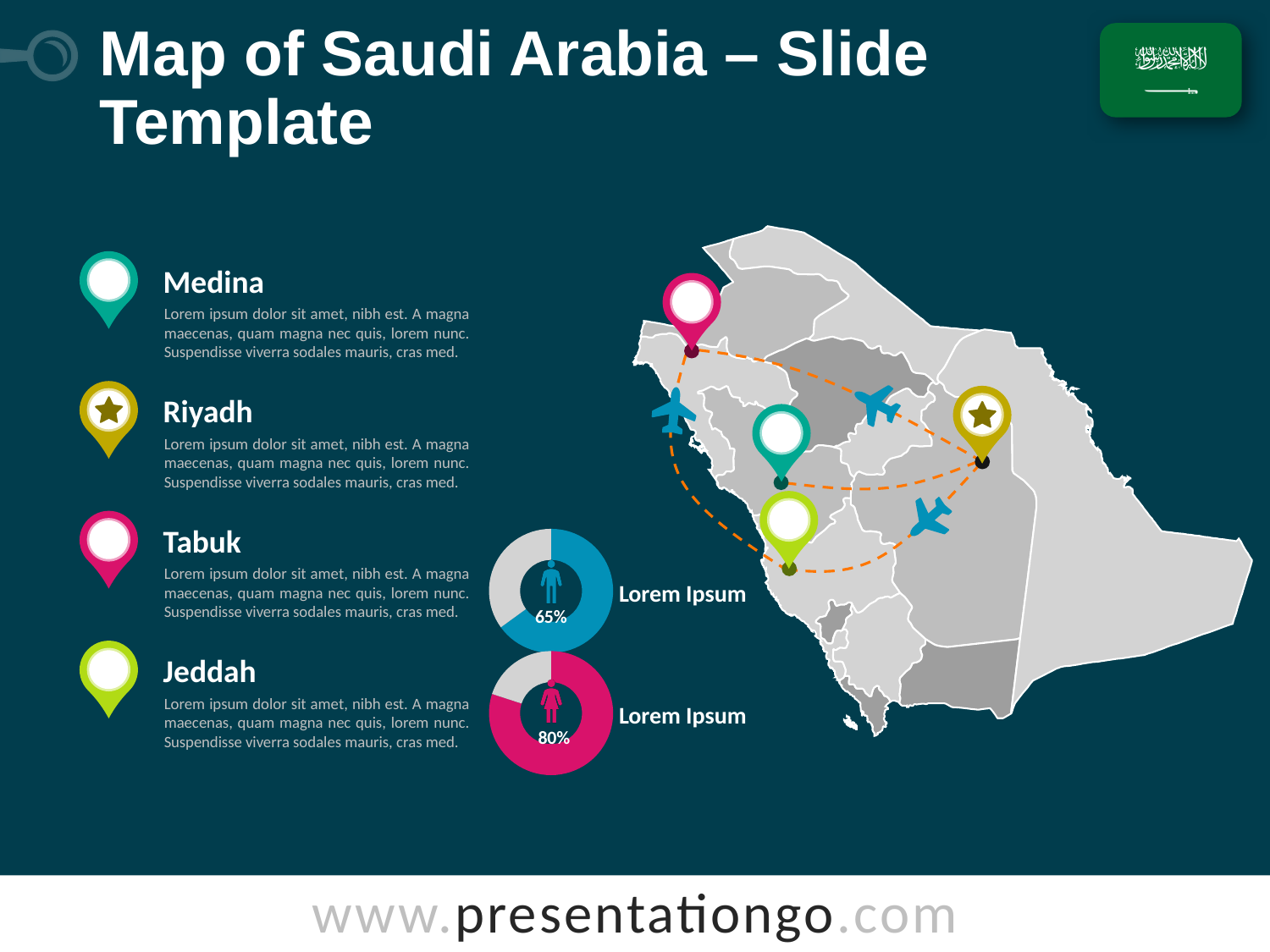
What percentage is shown in the upper (blue) donut chart? 65% What share of the upper blue donut chart is left unfilled (grey)? 35% What kind of charts are shown on the slide next to the map? donut charts Which donut chart shows the larger percentage, the upper blue one or the lower pink one? the lower pink one What label text appears to the right of each donut chart? Lorem Ipsum What share of the lower pink donut chart is left unfilled (grey)? 20% Is the value shown in the upper blue donut chart greater or less than 50%? greater How many donut charts are on the slide? 2 What colour is the filled portion of the donut chart showing 80%? pink What percentage is shown in the lower (pink) donut chart? 80% What is the difference between the percentage in the lower pink donut chart and the percentage in the upper blue donut chart? 15 percentage points